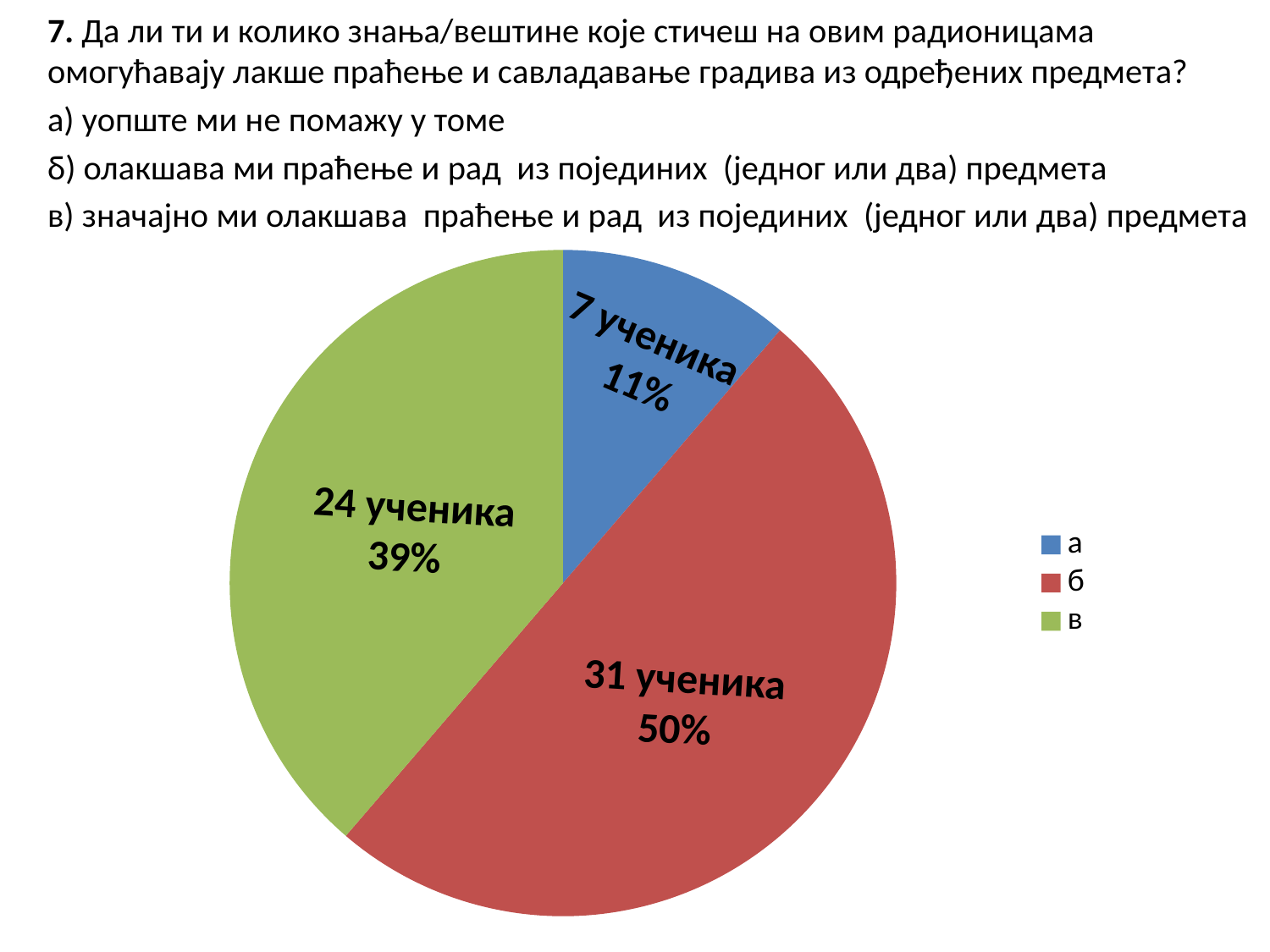
Which option has the smallest slice? а What kind of chart is shown on the slide? pie chart How many students chose option а? 7 ученика How many slices does the pie chart have? 3 What share of the pie does option в represent? 39% How many entries does the legend list? 3 How many students chose option б? 31 ученика How many more students chose option б than option в? 7 How many students chose option в? 24 ученика Which colour represents option в in the legend? green Which option has the largest slice? б What share of the pie does option а represent? 11%